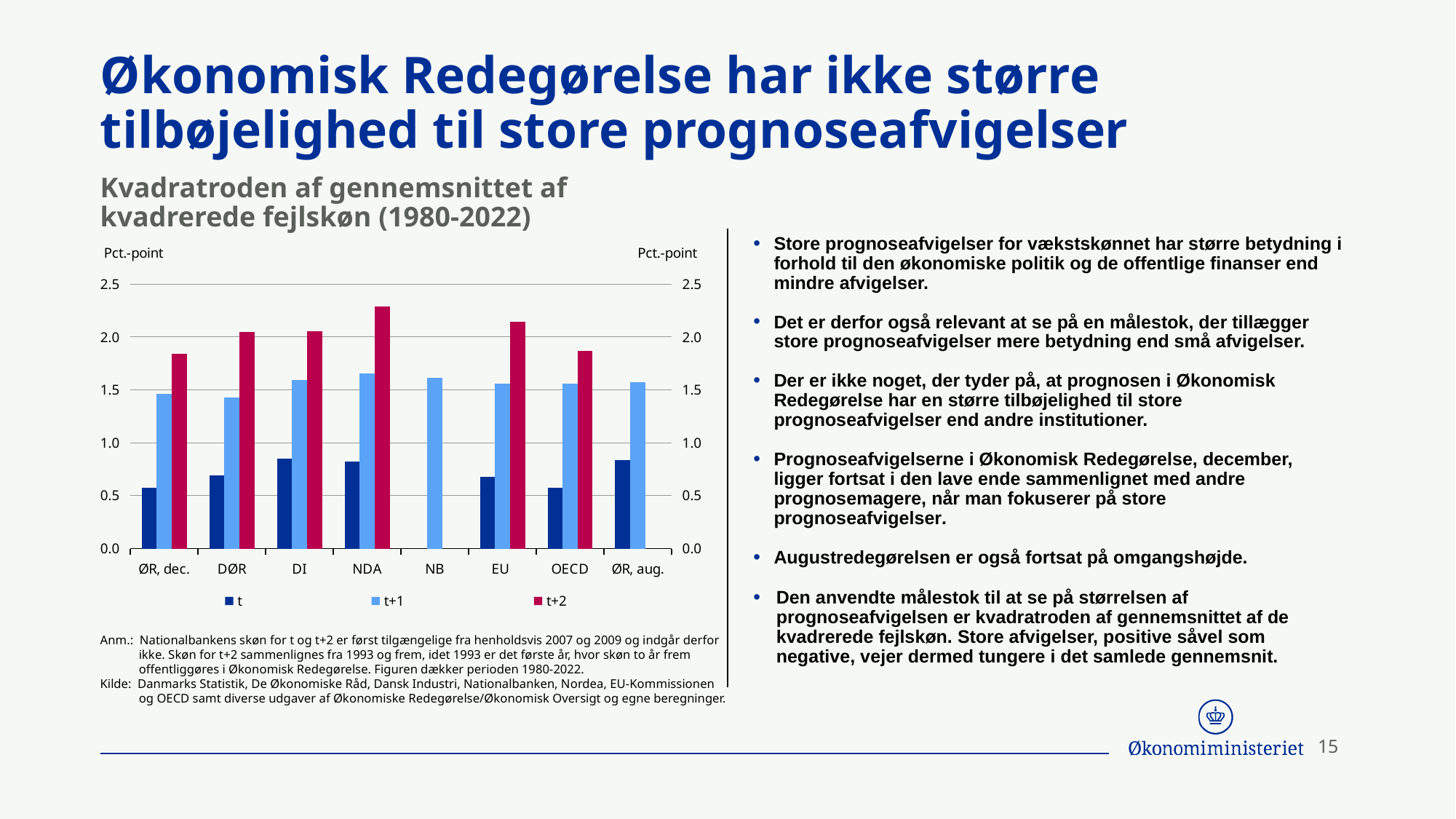
Which category shows only a t+1 bar and no t or t+2 bar? NB Is the t value for ØR, dec. greater or less than 1.0? less What unit is shown on the chart's y axis? Pct.-point Which is larger, the t+2 value for NDA or the t+2 value for EU? NDA How many series does the chart's legend list? 3 What kind of chart is shown on the slide? bar chart Is the t+2 value for ØR, dec. greater or less than 2.0? less Which category has the highest value for the t+2 series? NDA Which is larger, the t value for DI or the t value for ØR, dec.? DI Is the t+2 value for NDA greater or less than 2.0? greater How many categories are shown on the x axis of the chart? 8